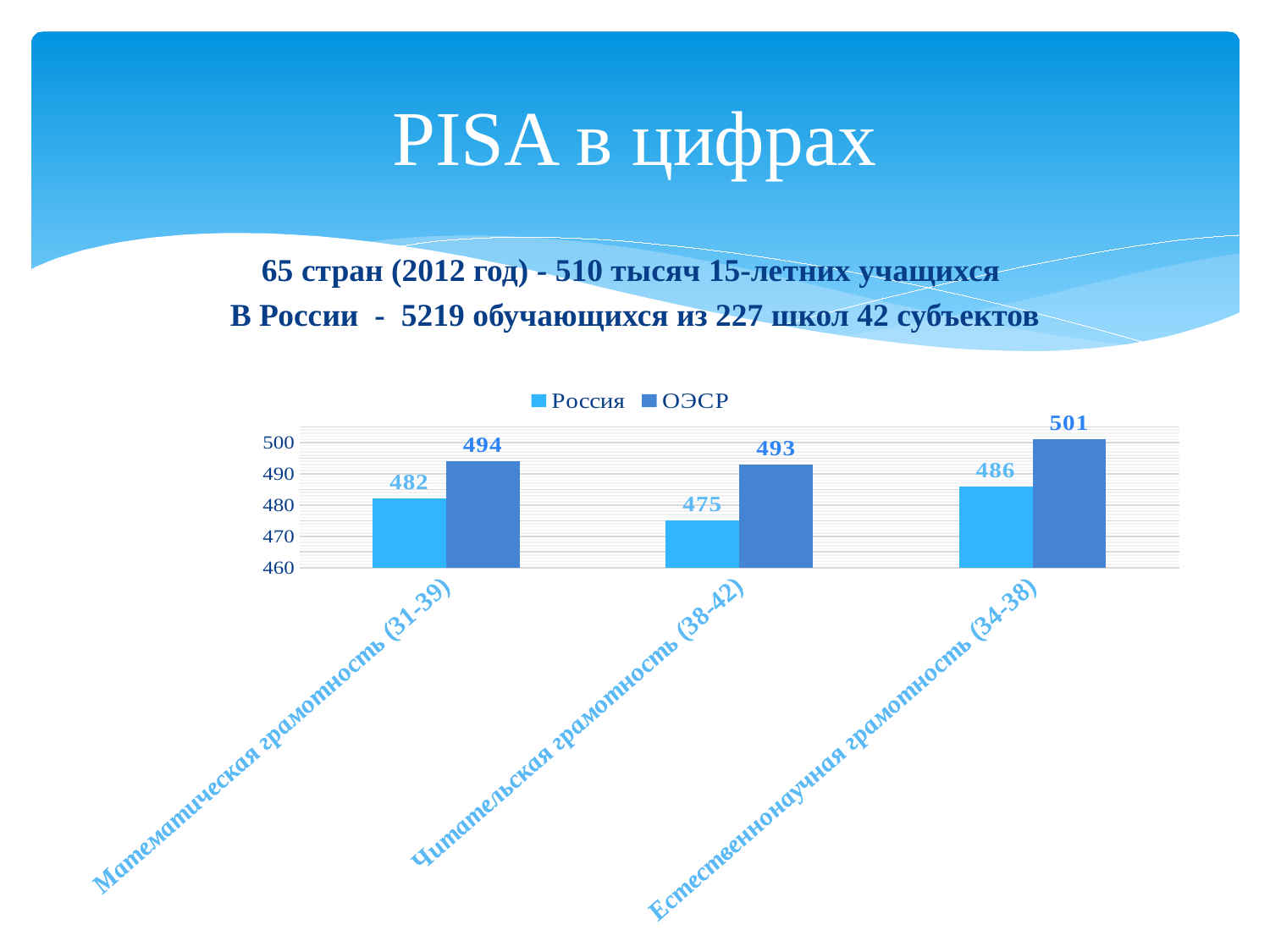
What kind of chart is shown on the slide? Bar chart What is the value for ОЭСР in Читательская грамотность (38-42)? 493 Which is larger in Естественнонаучная грамотность (34-38): Россия or ОЭСР? ОЭСР What is the difference between the ОЭСР and Россия values in Читательская грамотность (38-42)? 18 In which category does Россия have its lowest value? Читательская грамотность (38-42) What is the difference between the ОЭСР and Россия values in Математическая грамотность (31-39)? 12 In which category does ОЭСР have its highest value? Естественнонаучная грамотность (34-38) How many series does the legend list? 2 What is the value for ОЭСР in Естественнонаучная грамотность (34-38)? 501 What is the value for Россия in Математическая грамотность (31-39)? 482 How many categories are shown on the x axis? 3 What is the value for Россия in Естественнонаучная грамотность (34-38)? 486